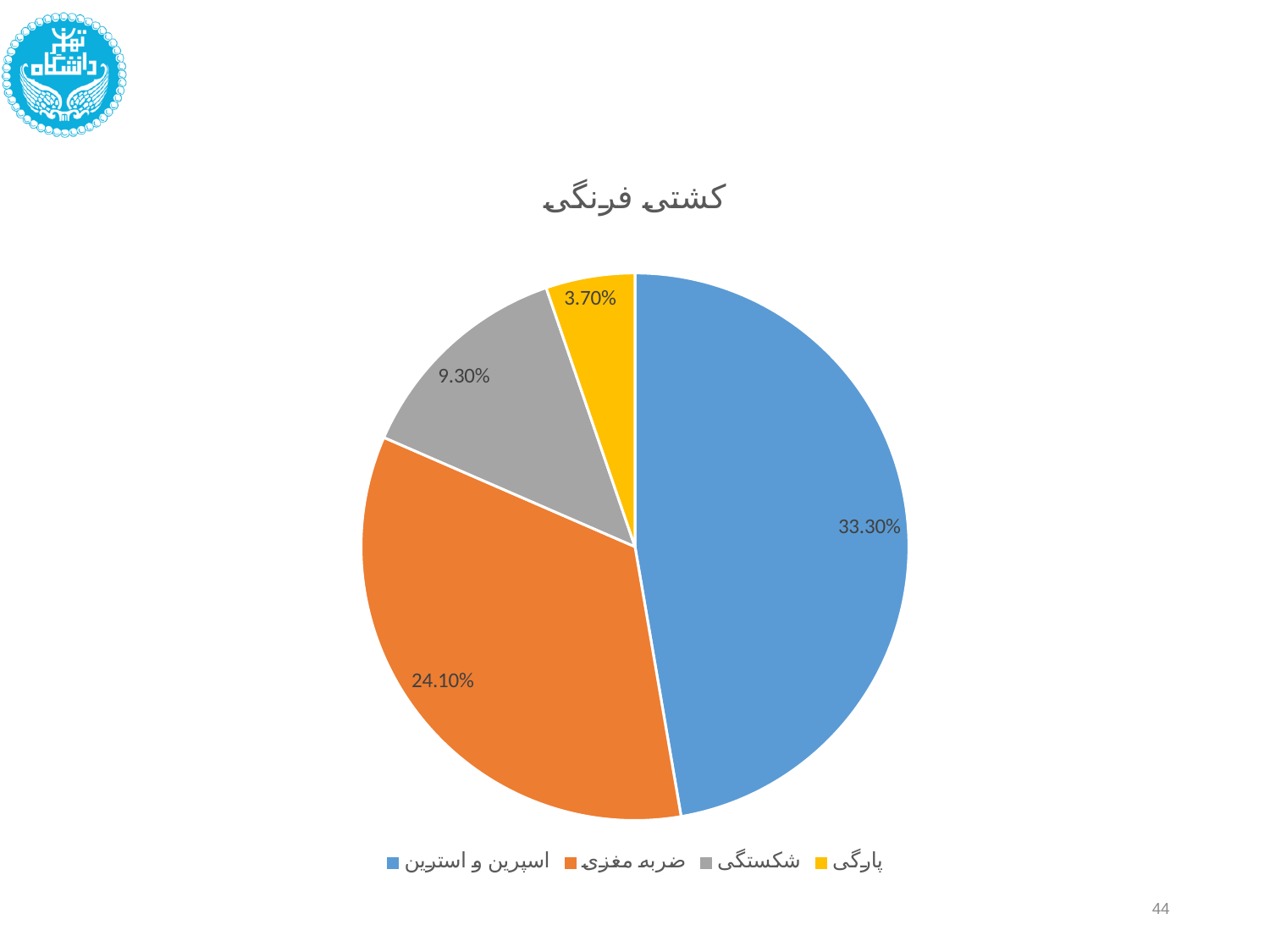
Which category has the smallest slice of the pie? پارگی What type of chart is shown on the slide? pie chart Which is larger, the value for شکستگی or the value for پارگی? شکستگی What value is shown for اسپرین و استرین? 33.30% What value is shown for پارگی? 3.70% What value is shown for شکستگی? 9.30% What colour is the slice for ضربه مغزی? orange What value is shown for ضربه مغزی? 24.10% Which category has the largest slice of the pie? اسپرین و استرین How many categories does the pie chart have? 4 What is the title of the chart? کشتی فرنگی What is the difference between the values for اسپرین و استرین and ضربه مغزی? 9.20%